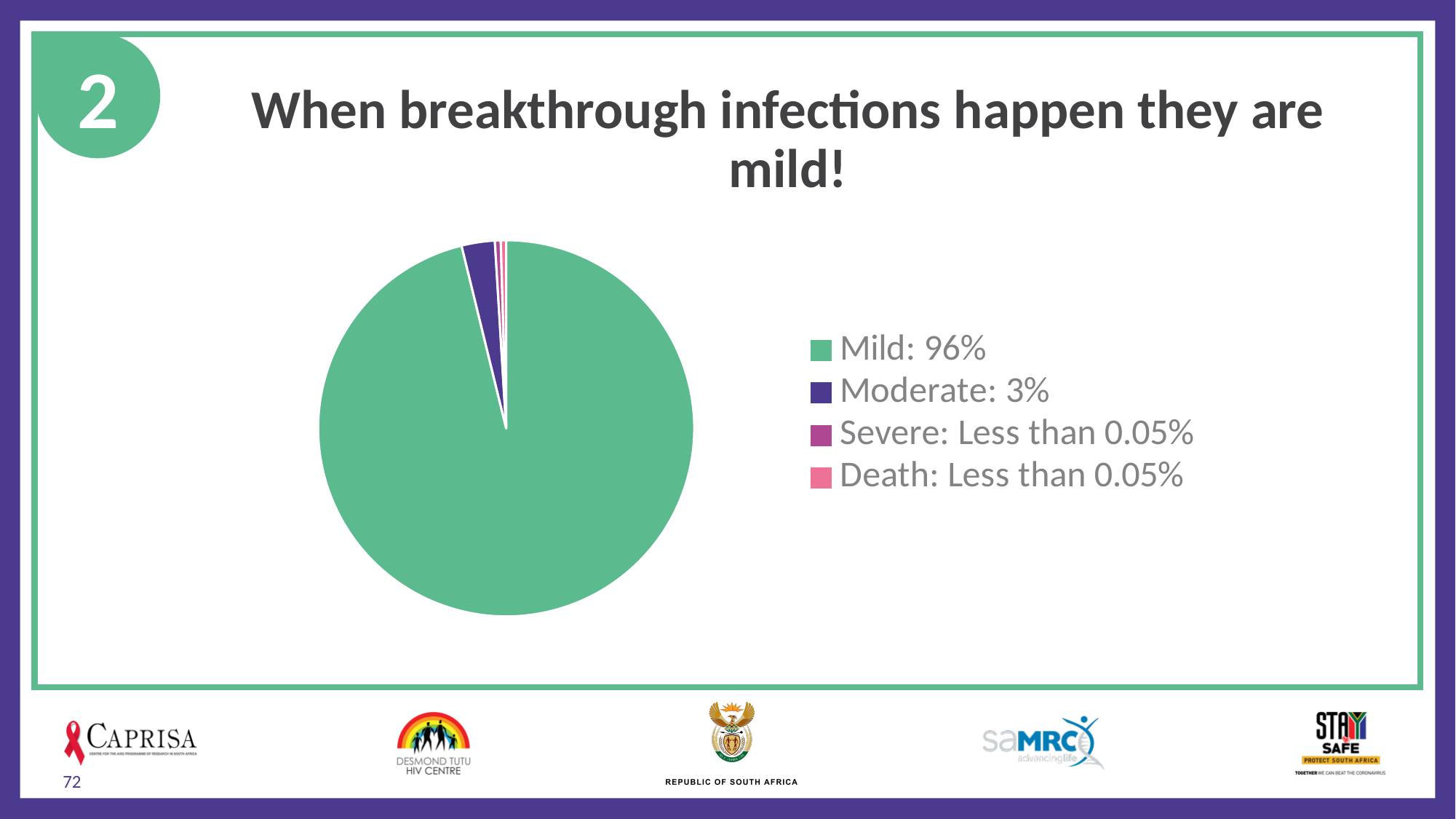
Which category has the largest slice of the pie? Mild What is the title of the slide containing the pie chart? When breakthrough infections happen they are mild! What share of breakthrough infections are Moderate according to the legend? 3% What value does the legend give for Severe? Less than 0.05% What is the difference between the Mild share and the Moderate share? 93% What share of breakthrough infections are Mild according to the legend? 96% What colour is the Mild slice of the pie chart? green What value does the legend give for Death? Less than 0.05% How many categories does the legend list? 4 Which is larger, the Mild slice or the Moderate slice? Mild What kind of chart is shown on the slide? pie chart